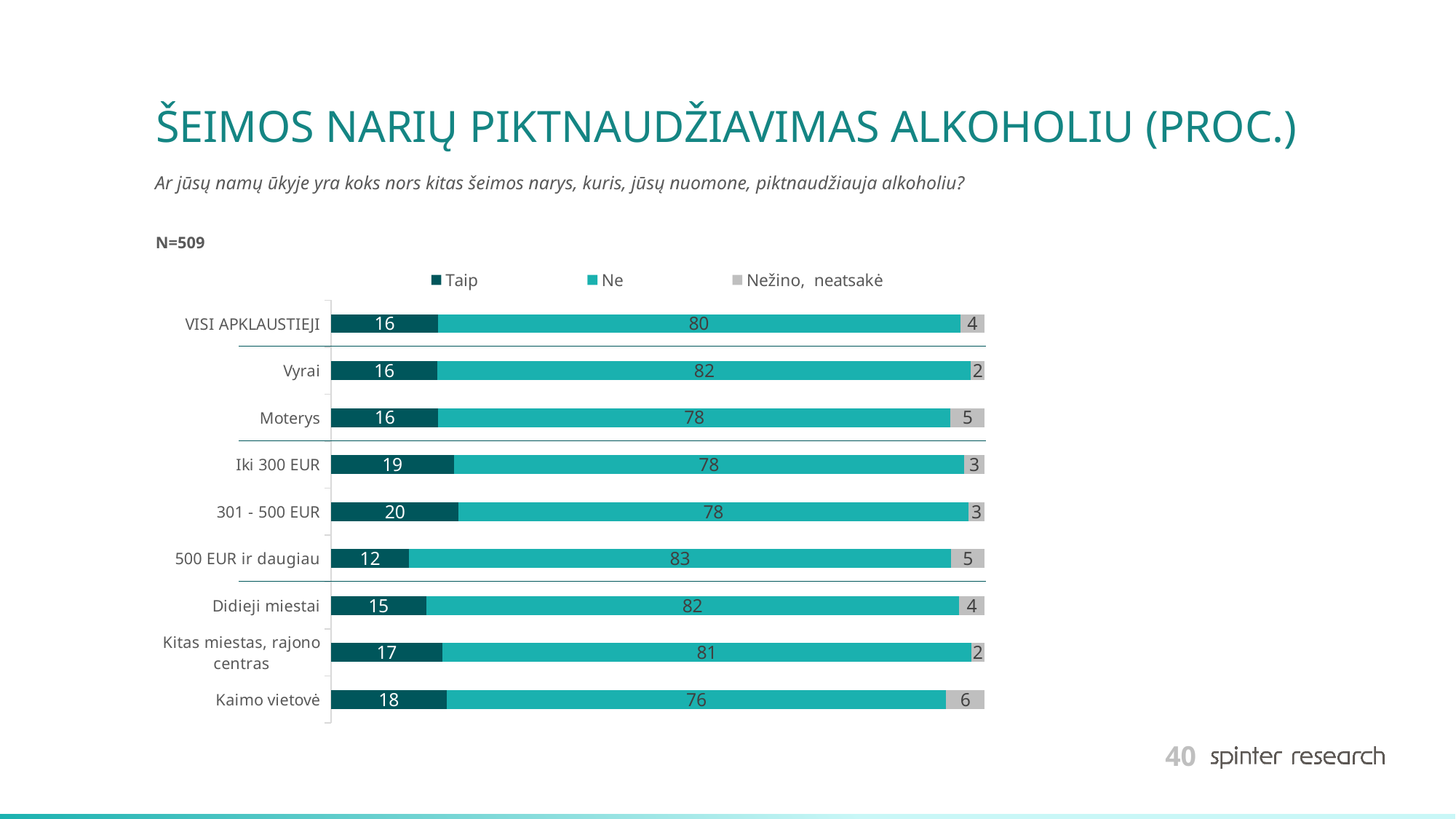
What kind of chart is shown on the slide? stacked bar chart What is the difference between the "Taip" values for "301 - 500 EUR" and "500 EUR ir daugiau"? 8 Which category has the highest "Taip" value? 301 - 500 EUR Which category has the lowest "Taip" value? 500 EUR ir daugiau Which has a larger "Ne" value, "Vyrai" or "Moterys"? Vyrai What is the total of the stacked bar for "Moterys"? 99 What is the "Ne" value for "500 EUR ir daugiau"? 83 Which category has the lowest "Ne" value? Kaimo vietovė What is the "Nežino, neatsakė" value for "Kaimo vietovė"? 6 What is the "Taip" value for "VISI APKLAUSTIEJI"? 16 How many categories are plotted on the chart? 9 How many series does the legend list? 3